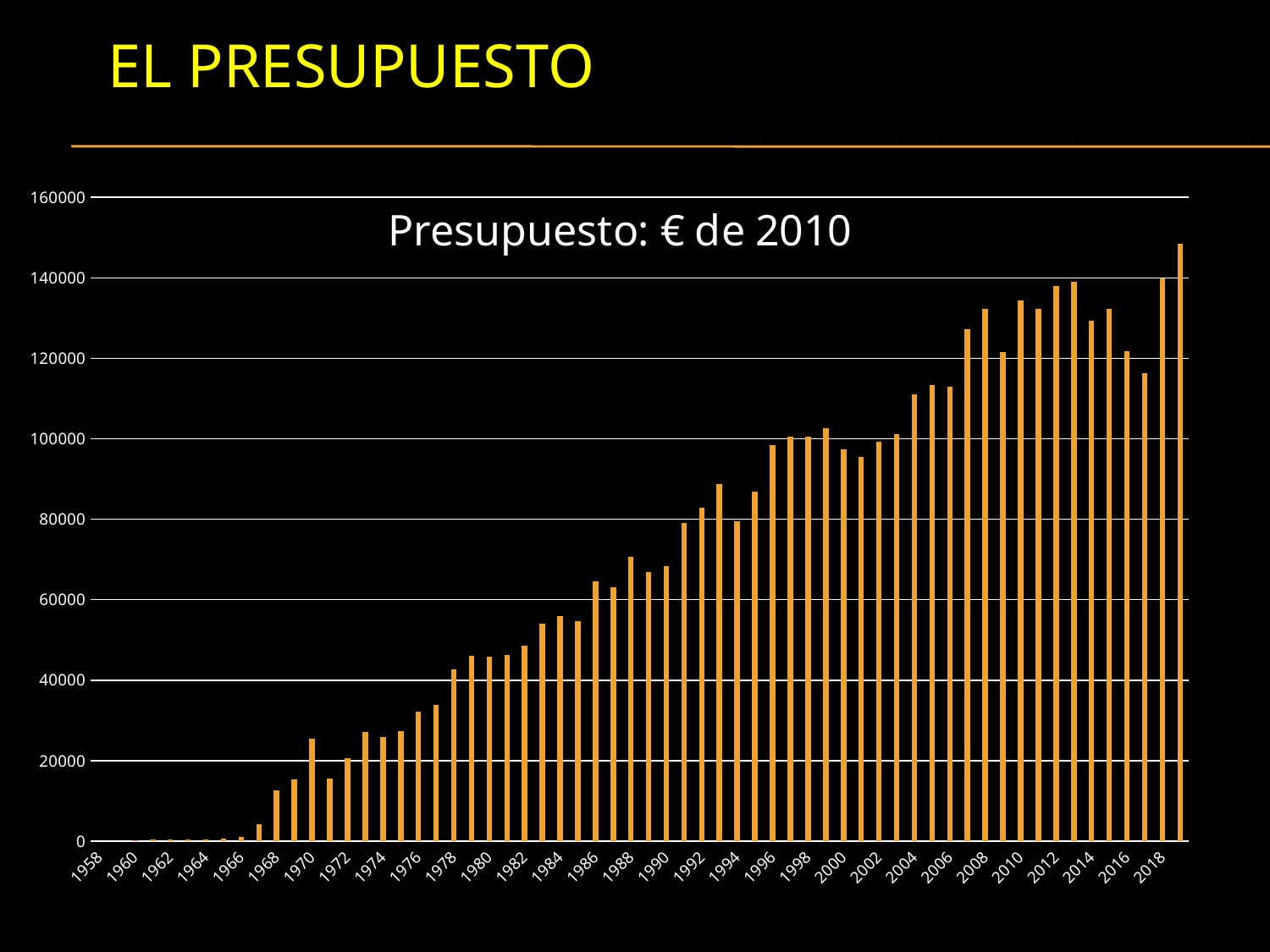
Is the value for 1980 greater or less than 40000? greater Which is larger, the value for 2016 or the value for 2018? 2018 Overall, do the values rise or fall from 1958 to 2019? rise Is the value for 1970 greater or less than 20000? greater Which year has the highest value in the chart? 2019 What is the title of the chart? Presupuesto: € de 2010 What kind of chart is shown on the slide? bar chart Which is larger, the value for 2010 or the value for 2000? 2010 Is the value for 2010 greater or less than 120000? greater